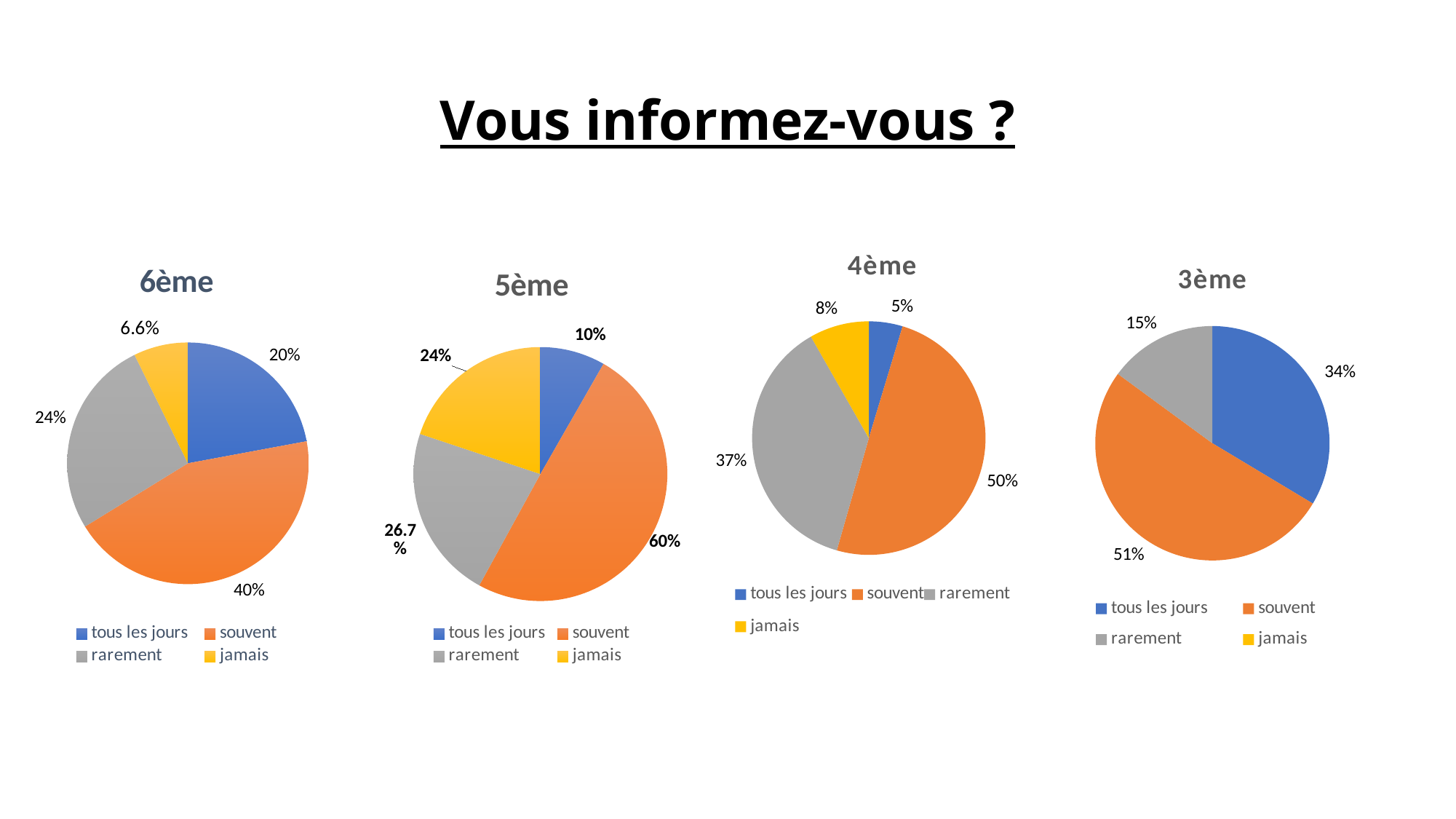
How many entries does the legend of the 4ème chart list? 4 What is the title of the slide? Vous informez-vous ? In the 6ème chart, what percentage is shown for "souvent"? 40% In the 5ème chart, what percentage is shown for "rarement"? 26.7% In the 4ème chart, what percentage is shown for "rarement"? 37% In the 6ème chart, which is larger, "tous les jours" or "rarement"? rarement In the 5ème chart, which category has the largest share? souvent What kind of chart is used for the 5ème data? pie chart In the 3ème chart, what is the difference between the "souvent" and "rarement" shares? 36% In the 3ème chart, what percentage is shown for "tous les jours"? 34% In the 6ème chart, what percentage is shown for "jamais"? 6.6% In the 4ème chart, which category has the smallest share? tous les jours